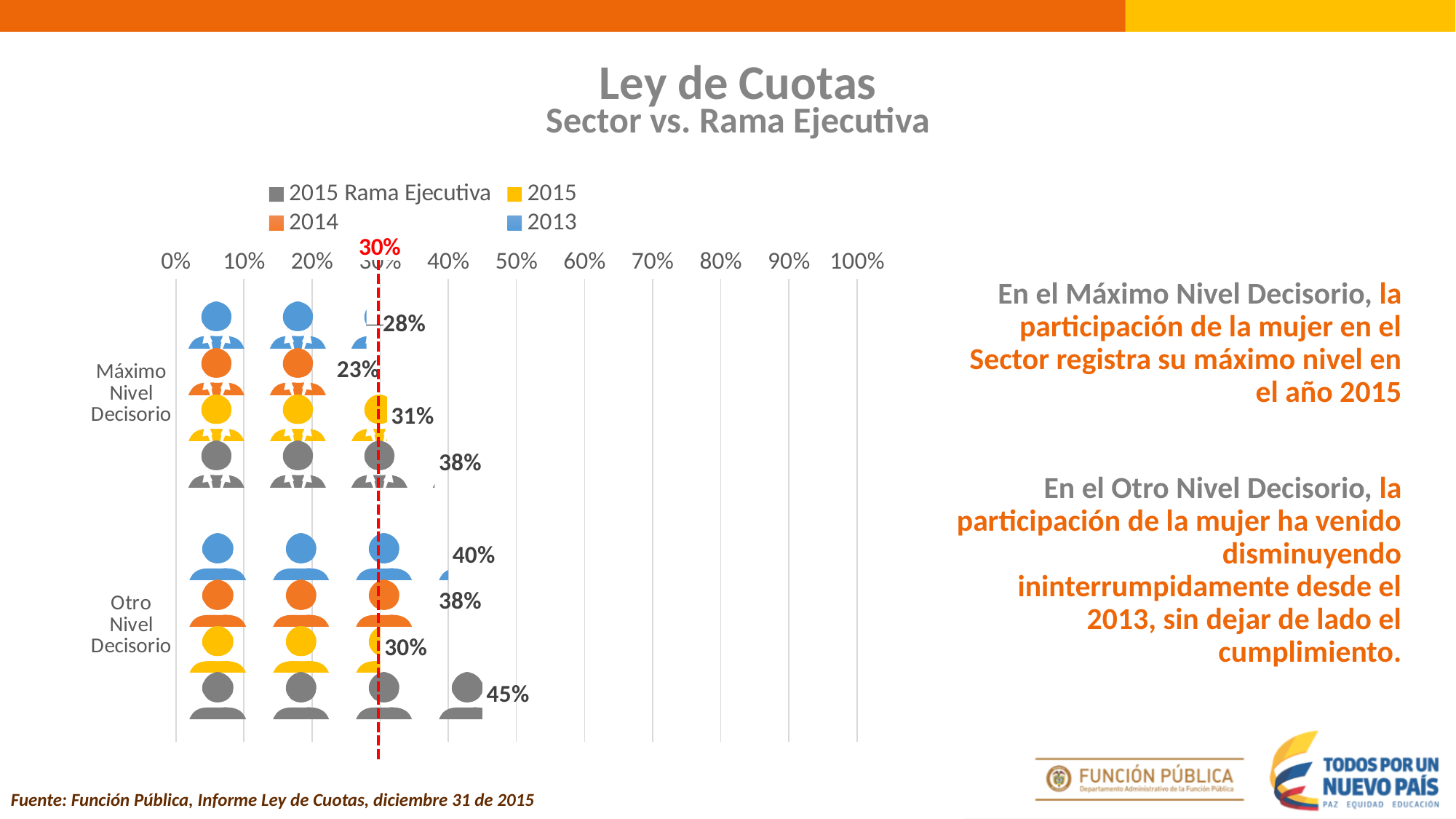
What is the value for 2015 Rama Ejecutiva in the Otro Nivel Decisorio category? 45% How many categories are shown on the chart? 2 What value does the red dashed vertical line on the chart mark? 30% What is the value for 2015 in the Máximo Nivel Decisorio category? 31% What is the value for 2014 in the Otro Nivel Decisorio category? 38% Which series has the highest value in the Otro Nivel Decisorio category? 2015 Rama Ejecutiva What is the difference between the 2015 Rama Ejecutiva value and the 2015 value in the Máximo Nivel Decisorio category? 7% Which is larger in the Otro Nivel Decisorio category, the 2013 value or the 2015 value? 2013 What is the value for 2013 in the Máximo Nivel Decisorio category? 28% Do the values for the Otro Nivel Decisorio category rise or fall from 2013 to 2015? fall How many series does the legend list? 4 Which series has the lowest value in the Máximo Nivel Decisorio category? 2014